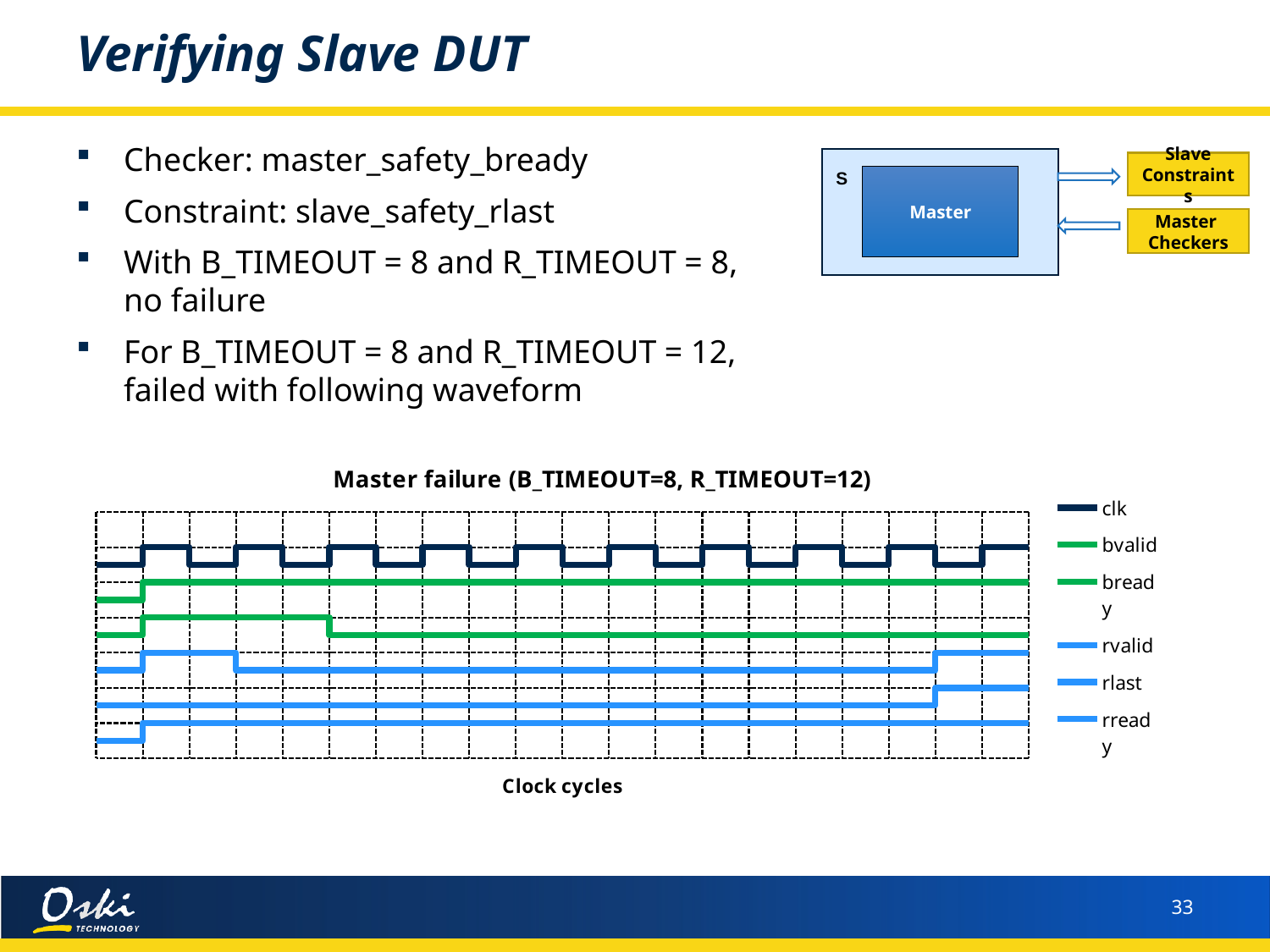
How many series does the legend of the waveform chart list? 6 In the waveform chart, does the rvalid signal end at a higher or lower level than it starts? higher In the waveform chart, does the bready signal end at a higher or lower level than it starts? Neither; it ends at the same level it starts What is the x-axis label of the waveform chart? Clock cycles In the waveform chart, does the bvalid signal end at a higher or lower level than it starts? higher What kind of chart is the waveform chart on the slide? line chart What is the title of the waveform chart on the slide? Master failure (B_TIMEOUT=8, R_TIMEOUT=12)